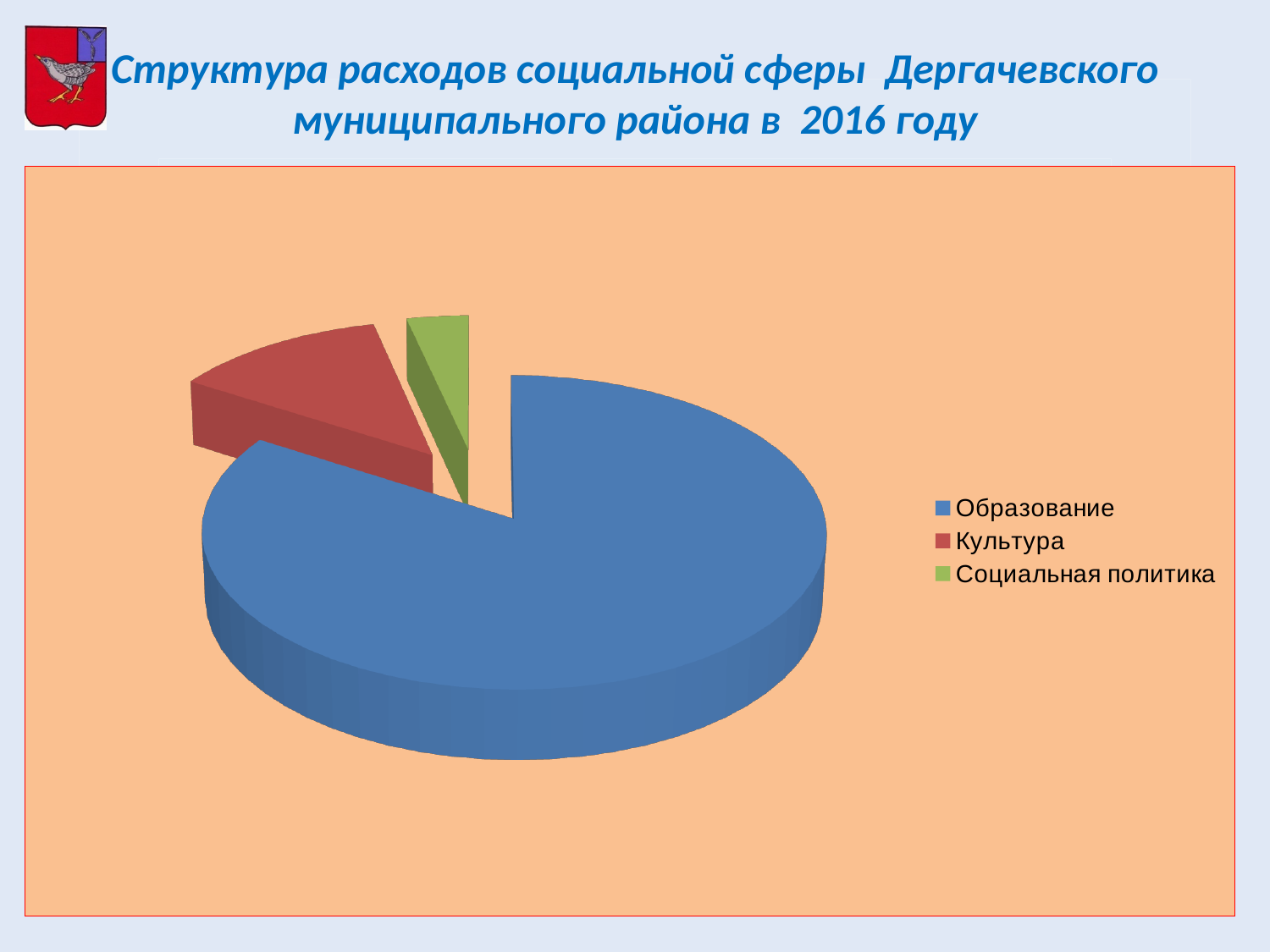
How many slices does the pie chart have? 3 How many entries does the legend of the pie chart list? 3 What colour is the slice for Культура in the pie chart? red Which category has the smallest slice of the pie chart? Социальная политика Which slice is larger, Культура or Социальная политика? Культура Which category has the largest slice of the pie chart? Образование What is the title of the chart on the slide? Структура расходов социальной сферы Дергачевского муниципального района в 2016 году Which slice is larger, Образование or Культура? Образование What kind of chart is shown on the slide? pie chart